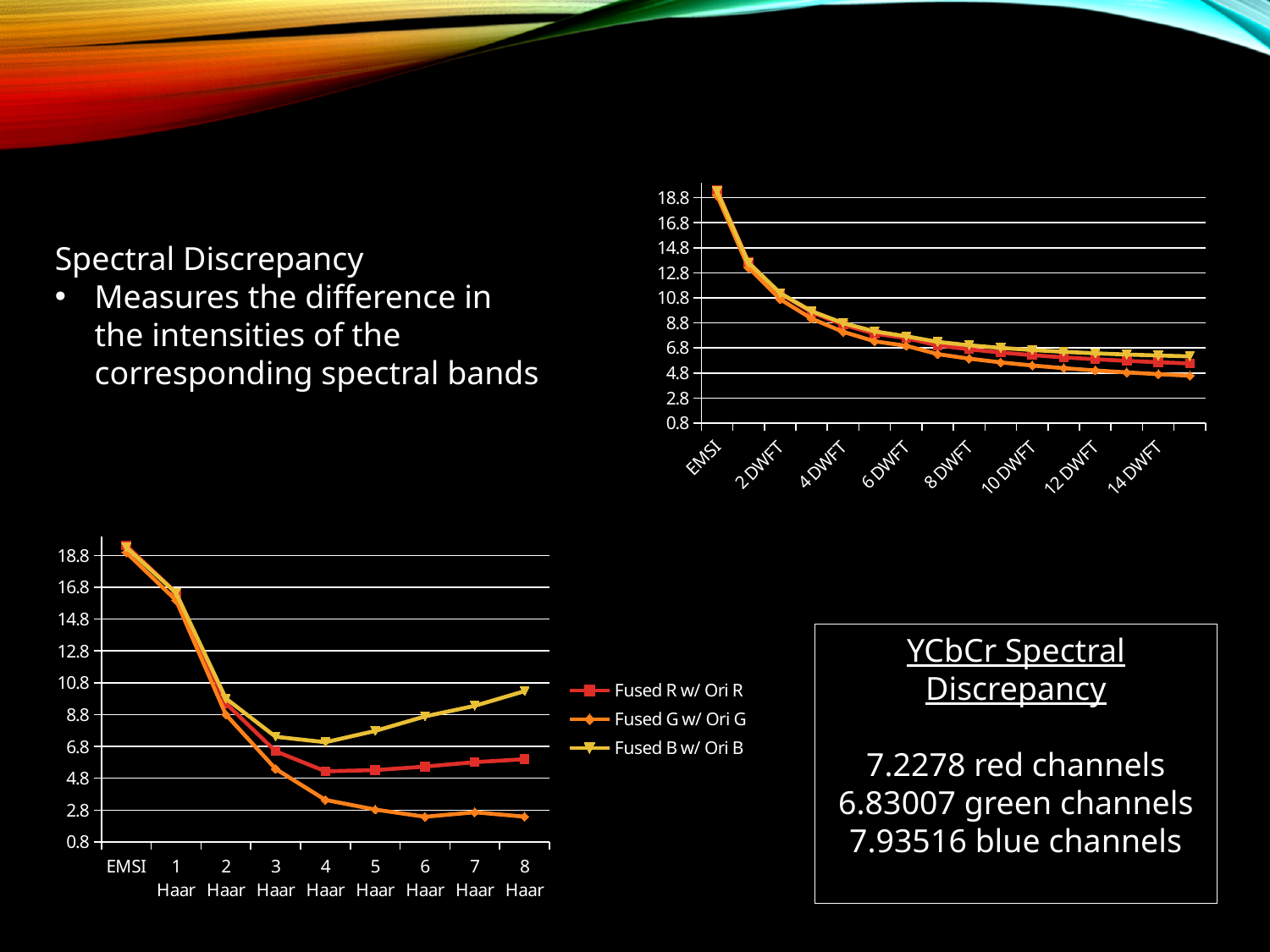
In the bottom-left chart, how many series does the legend list? 3 In the bottom-left chart, which series has the lowest value at 8 Haar? Fused G w/ Ori G In the bottom-left chart, is the value of Fused B w/ Ori B at 8 Haar greater or less than 8.8? greater What kind of chart is the chart in the bottom-left of the slide? line chart In the bottom-left chart, which series has the highest value at 8 Haar? Fused B w/ Ori B In the bottom-left chart, is the value of Fused G w/ Ori G at 6 Haar greater or less than 2.8? less In the bottom-left chart, what is the first category label on the x axis? EMSI In the bottom-left chart, at 4 Haar, which is larger: Fused R w/ Ori R or Fused G w/ Ori G? Fused R w/ Ori R In the top-right chart, are the values at 14 DWFT greater or less than 6.8? less In the bottom-left chart, how many categories are shown on the x axis? 9 In the top-right chart, do the values generally rise or fall from EMSI to 14 DWFT? fall What kind of chart is the chart in the top-right of the slide? line chart